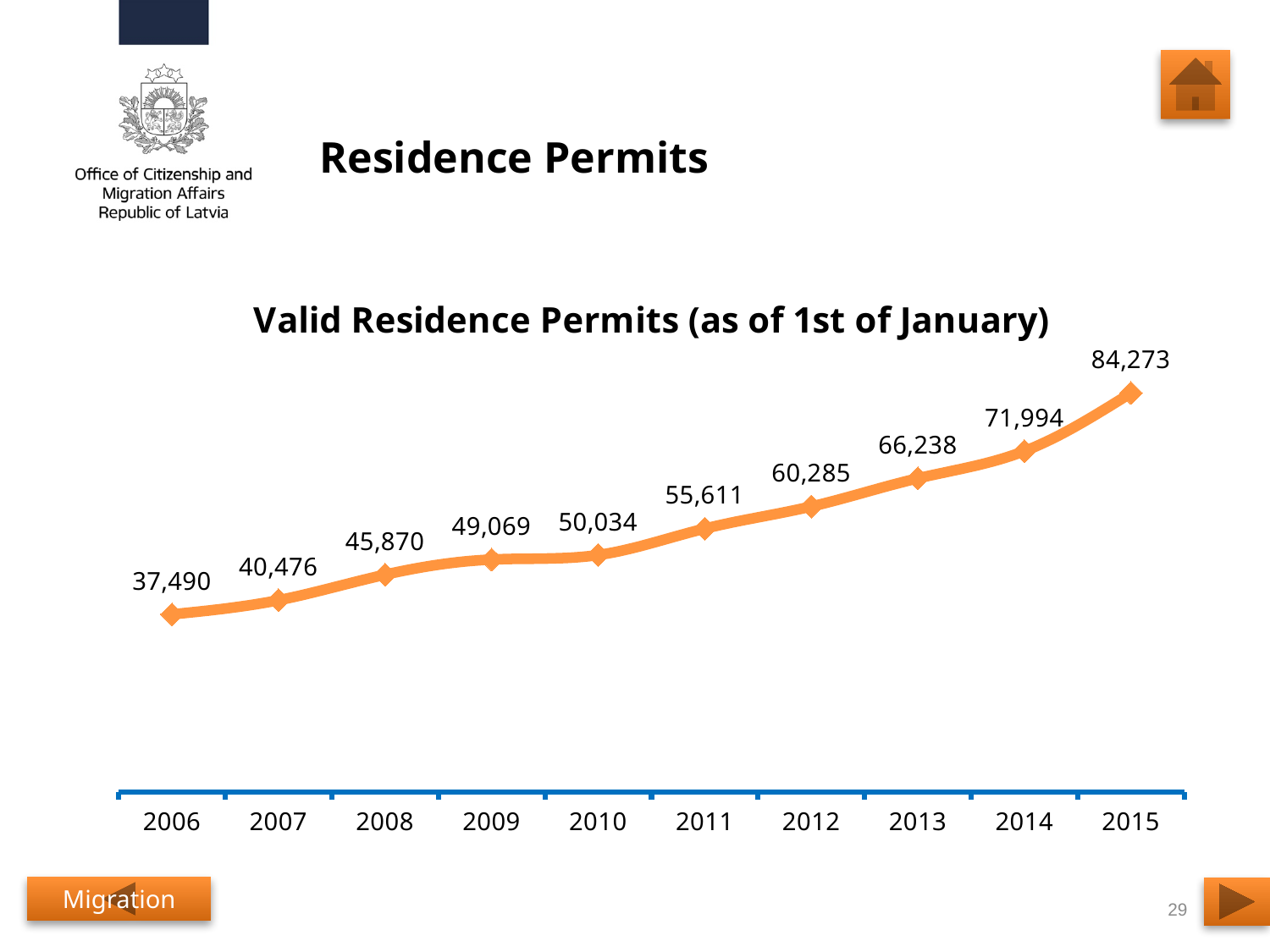
Which year has the highest number of valid residence permits? 2015 What is the difference between the values for 2010 and 2009? 965 How many years are plotted on the chart? 10 What is the value for 2011? 55,611 Do the values rise or fall from 2006 to 2015? Rise What is the value for 2015? 84,273 What kind of chart is shown? Line chart Which is larger, the value for 2012 or the value for 2013? 2013 What is the value for 2006? 37,490 What is the title of the chart? Valid Residence Permits (as of 1st of January) Which year has the lowest number of valid residence permits? 2006 What is the difference between the values for 2015 and 2014? 12,279